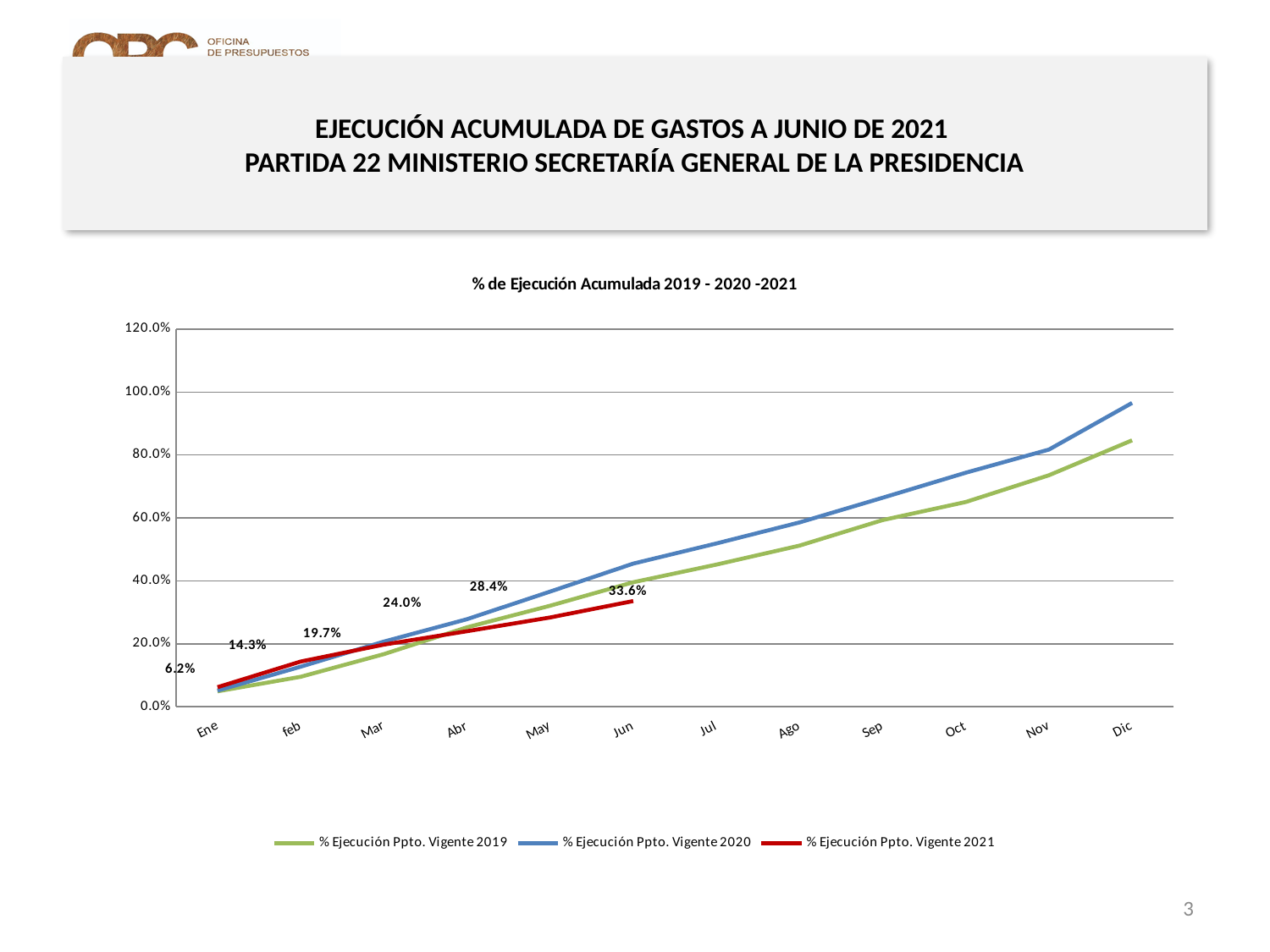
What is the difference between the 2021 values for May and Abr? 4.4% Is the value for % Ejecución Ppto. Vigente 2020 in Dic greater or less than 80.0%? greater What is the value of % Ejecución Ppto. Vigente 2021 in Ene? 6.2% What kind of chart is shown on the slide? line chart What is the value of % Ejecución Ppto. Vigente 2021 in Mar? 19.7% In Dic, which series is higher: % Ejecución Ppto. Vigente 2019 or % Ejecución Ppto. Vigente 2020? % Ejecución Ppto. Vigente 2020 What is the value of % Ejecución Ppto. Vigente 2021 in Jun? 33.6% What is the title of the chart? % de Ejecución Acumulada 2019 - 2020 -2021 Does the % Ejecución Ppto. Vigente 2021 series rise or fall from Ene to Jun? rise How many months are shown on the x axis? 12 How many series does the legend list? 3 What is the difference between the 2021 values for Jun and Ene? 27.4%